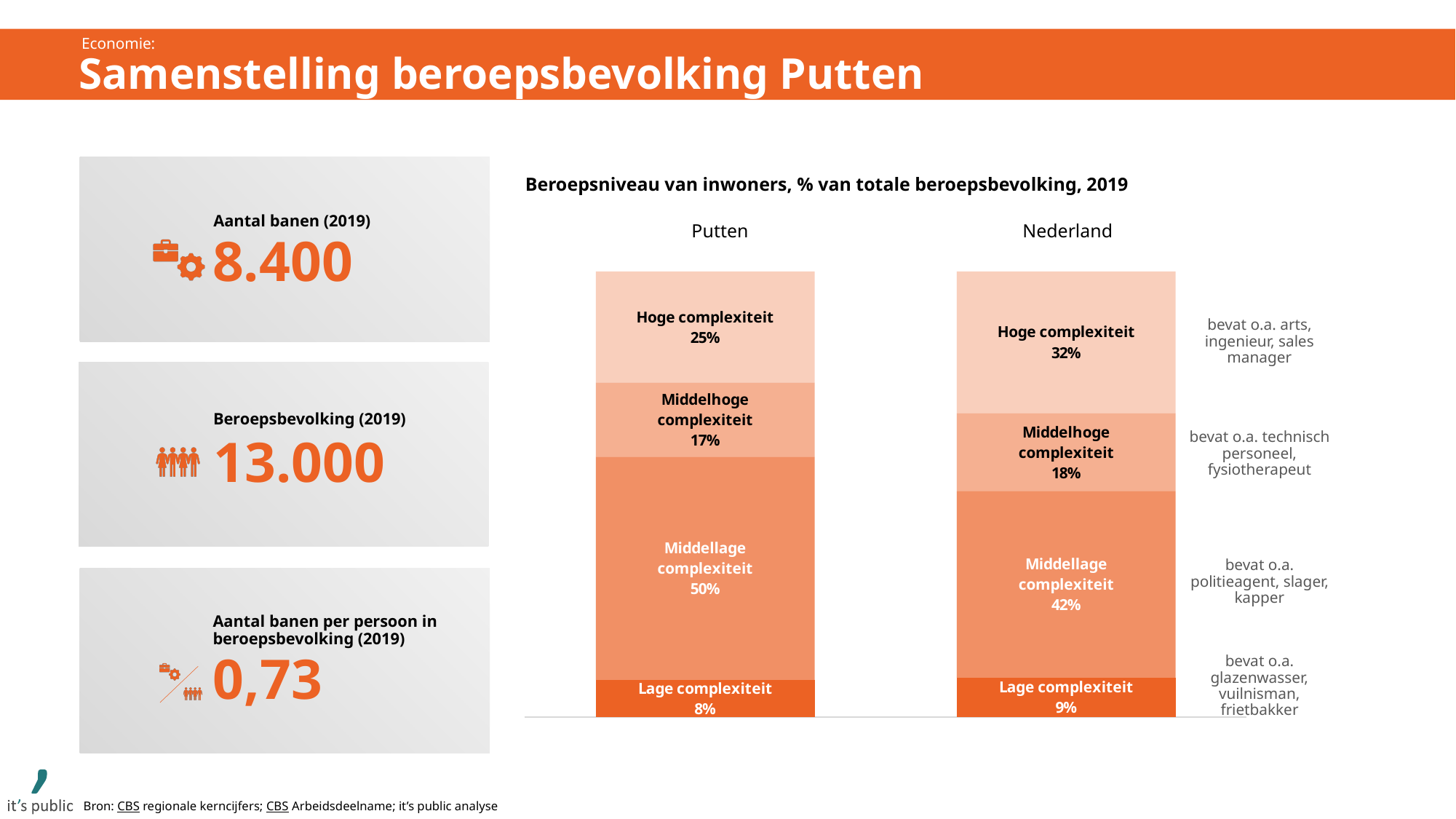
How many bars are shown in the chart? 2 What is the value for Middellage complexiteit in the Nederland bar? 42% How many segments does each stacked bar contain? 4 What is the title of the chart? Beroepsniveau van inwoners, % van totale beroepsbevolking, 2019 What type of chart is shown on the slide? Stacked bar chart Which segment is the smallest in the Nederland bar? Lage complexiteit What is the difference between the Middellage complexiteit values for Putten and Nederland? 8 percentage points Which segment is the largest in the Putten bar? Middellage complexiteit Which has a higher Hoge complexiteit share, Putten or Nederland? Nederland What is the value for Lage complexiteit in the Putten bar? 8% What is the value for Middelhoge complexiteit in the Nederland bar? 18% What is the value for Hoge complexiteit in the Putten bar? 25%